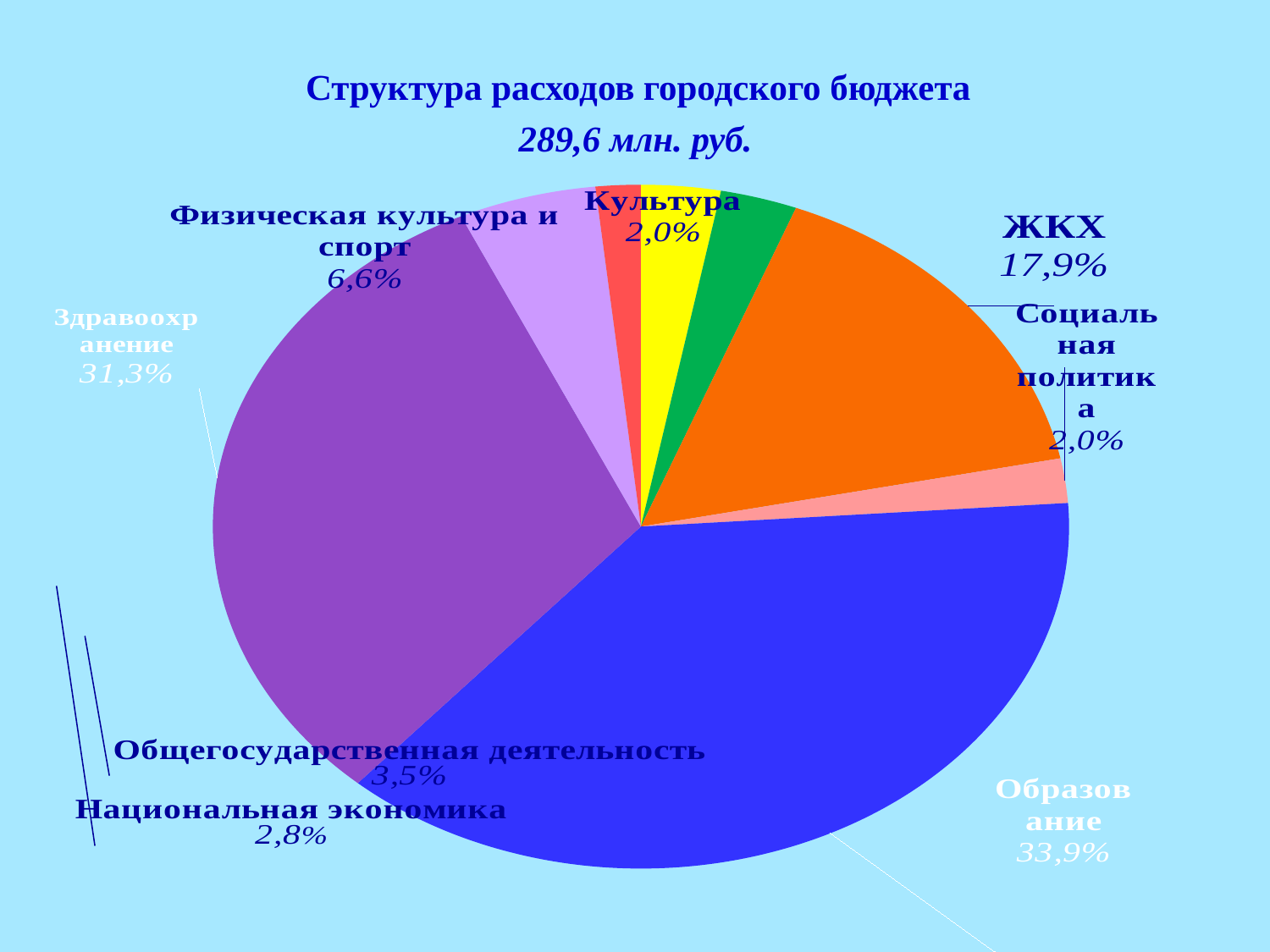
What share of the budget goes to Образование? 33,9% How many categories are shown in the pie chart? 8 What total amount of expenditure is stated under the chart title? 289,6 млн. руб. Which category has the largest share of the budget? Образование What is the title of the chart? Структура расходов городского бюджета Which is larger, the share for Здравоохранение or the share for ЖКХ? Здравоохранение What share of the budget goes to Физическая культура и спорт? 6,6% What share of the budget goes to Здравоохранение? 31,3% By how many percentage points does the share for Образование exceed the share for Здравоохранение? 2,6 What kind of chart is shown on the slide? Pie chart What share of the budget goes to ЖКХ? 17,9% What share of the budget goes to Национальная экономика? 2,8%